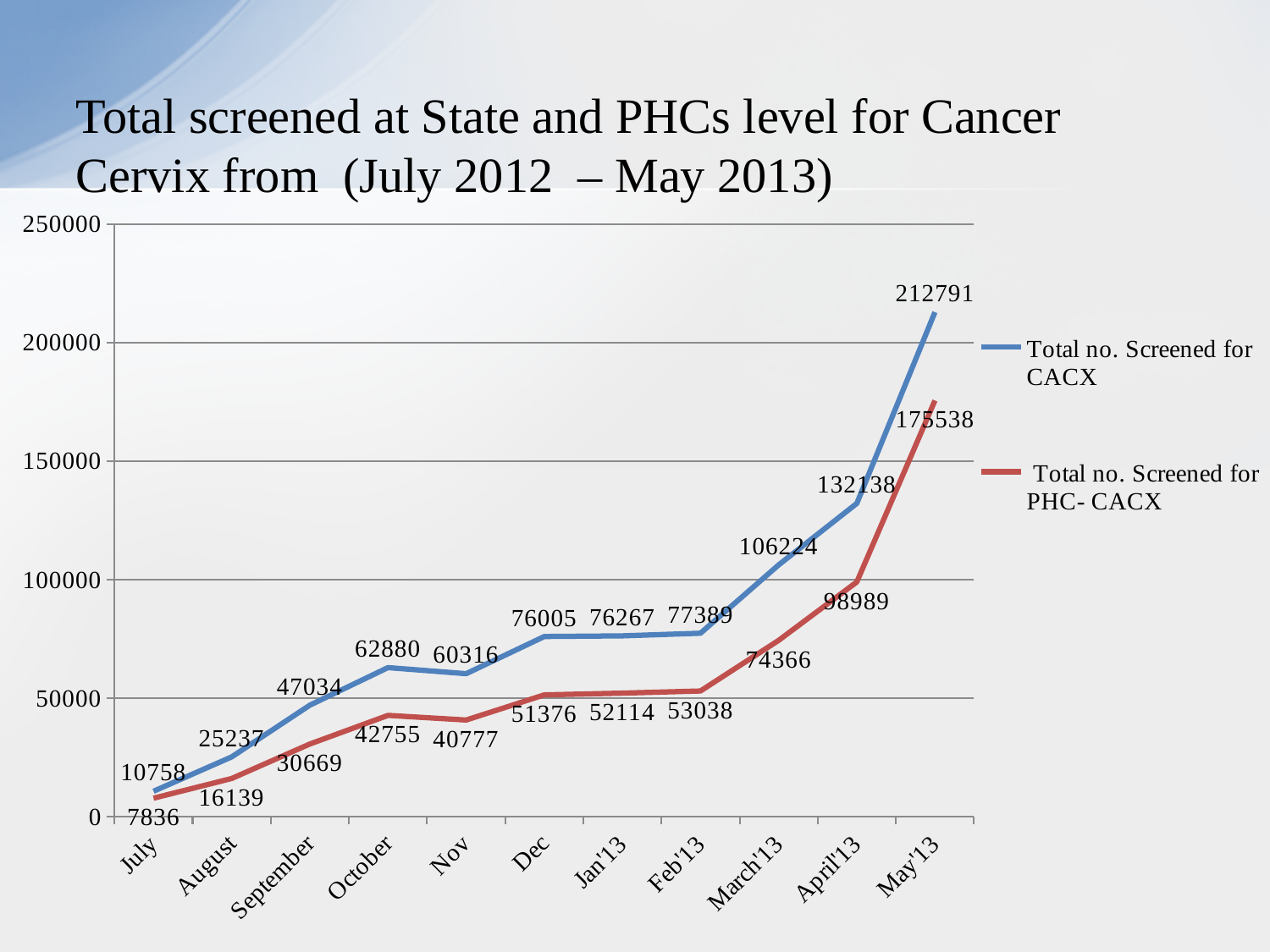
In which month is Total no. Screened for PHC- CACX lowest? July By how much did Total no. Screened for CACX increase from April'13 to May'13? 80653 What is the difference between Total no. Screened for CACX and Total no. Screened for PHC- CACX in May'13? 37253 How many months are shown on the x axis? 11 Does Total no. Screened for PHC- CACX generally rise or fall from July to May'13? Rise What is the value of Total no. Screened for PHC- CACX in March'13? 74366 What is the value of Total no. Screened for CACX in October? 62880 Which is larger in Nov: Total no. Screened for CACX or Total no. Screened for PHC- CACX? Total no. Screened for CACX In which month is Total no. Screened for CACX highest? May'13 How many series does the legend list? 2 What is the value of Total no. Screened for CACX in Jan'13? 76267 What kind of chart is shown on the slide? Line chart